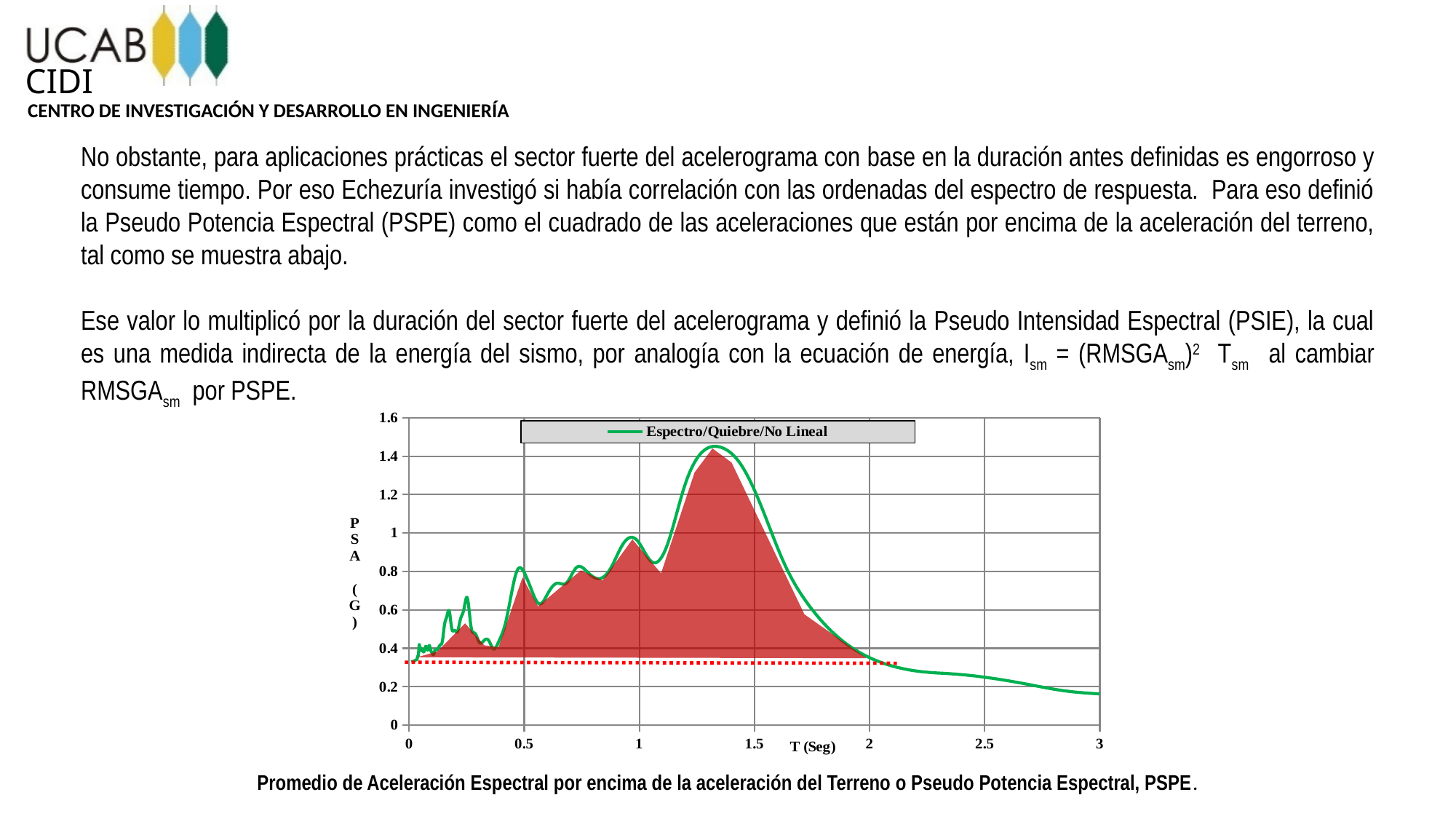
How many series does the chart legend list? 1 Which is larger, the value of the line at T = 1.5 or at T = 3? T = 1.5 Is the value of the Espectro/Quiebre/No Lineal line at T = 1 greater or less than 0.8? greater Is the value of the Espectro/Quiebre/No Lineal line at T = 3 greater or less than 0.2? less Is the value of the Espectro/Quiebre/No Lineal line at T = 0.5 greater or less than 0.6? greater What kind of chart is shown on the slide? line chart What caption is printed below the chart? Promedio de Aceleración Espectral por encima de la aceleración del Terreno o Pseudo Potencia Espectral, PSPE. Between T = 1.5 and T = 3, does the Espectro/Quiebre/No Lineal line rise or fall? fall Which is larger, the value of the line at T = 1 or at T = 2? T = 1 What is the name of the series listed in the chart legend? Espectro/Quiebre/No Lineal